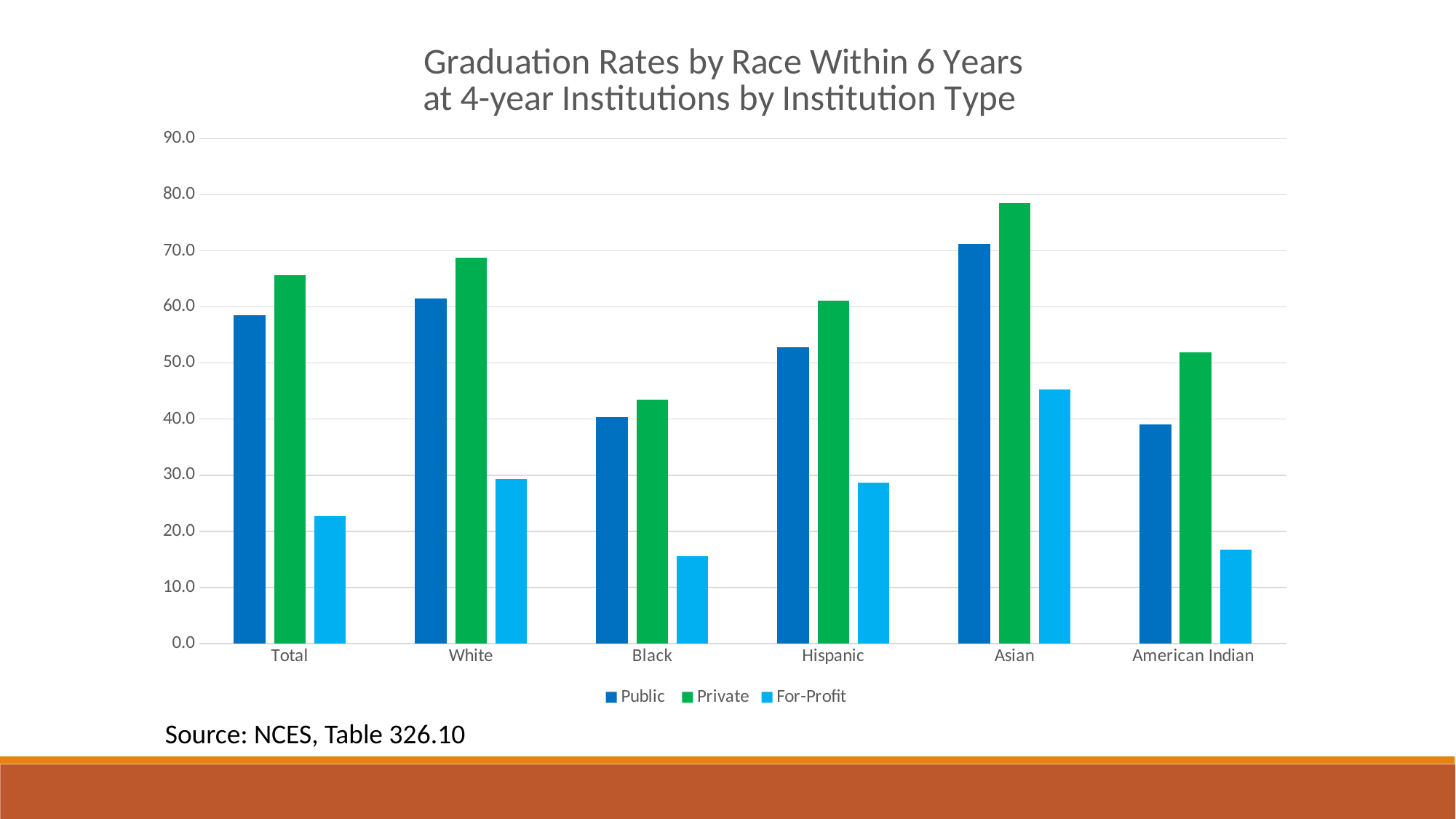
Is the For-Profit value for Asian greater or less than 40.0? greater For Hispanic, which is larger: the Public value or the Private value? Private Which category has the highest For-Profit graduation rate? Asian Is the Public value for Total greater or less than 50.0? greater Is the Private value for Asian greater or less than 70.0? greater Which series is shown in green in the legend? Private What kind of chart is shown on the slide? bar chart How many race categories are shown along the x axis? 6 How many series does the legend list? 3 Which category has the lowest Private graduation rate? Black Which category has the highest Private graduation rate? Asian